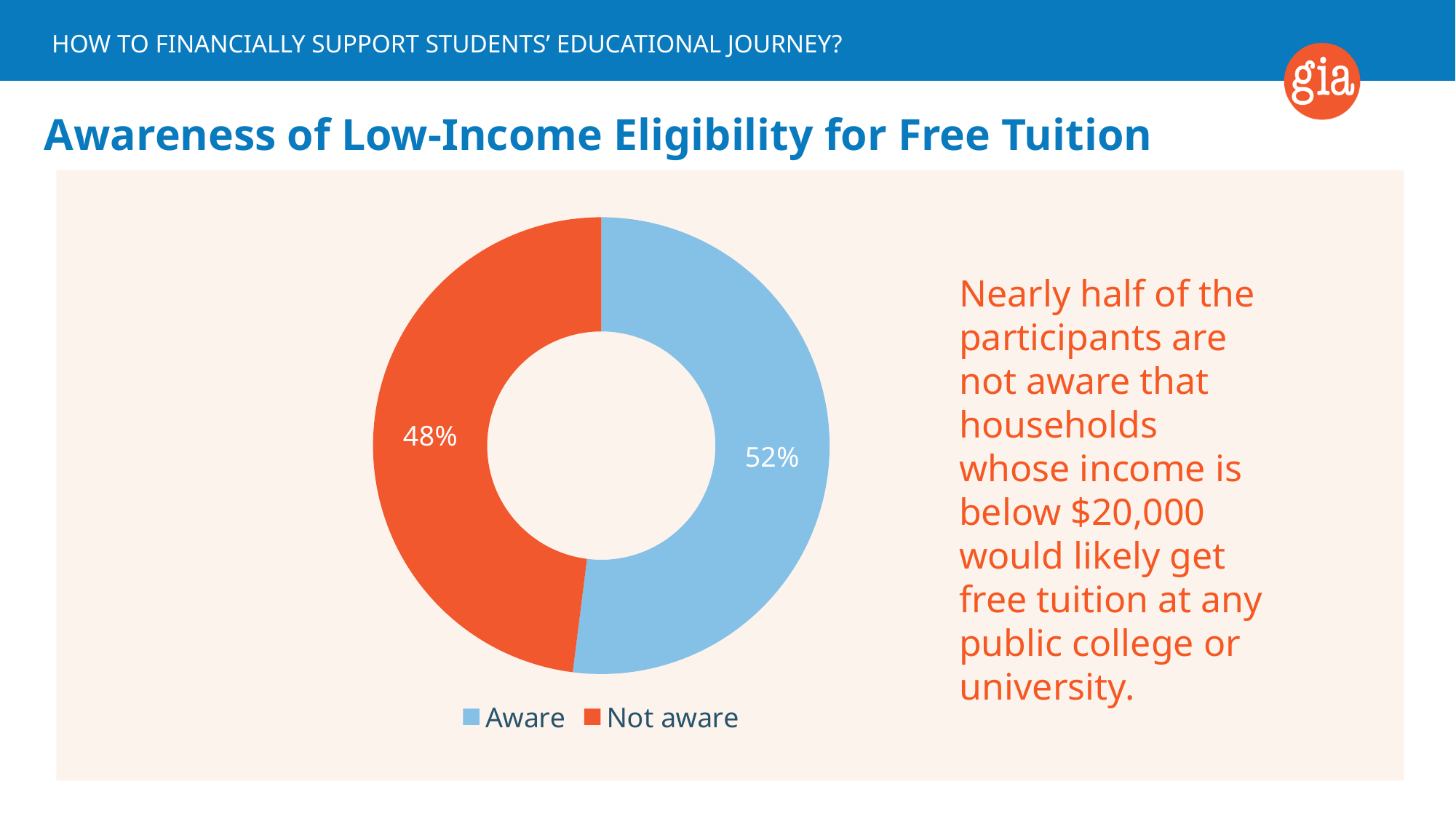
Which category has the smaller share of the chart? Not aware What kind of chart is shown on the slide? Pie chart (doughnut) How many categories does the chart show? 2 What percentage of participants are not aware of low-income eligibility for free tuition? 48% What share of the pie does the Not aware slice represent? 48% Which colour represents the Not aware category in the chart? Orange Which category has the larger share of the chart? Aware What is the title of the chart on the slide? Awareness of Low-Income Eligibility for Free Tuition How many entries does the legend list? 2 What is the difference in percentage points between the Aware and Not aware shares? 4 percentage points Is the share for Aware larger or smaller than the share for Not aware? larger What percentage of participants are aware of low-income eligibility for free tuition? 52%